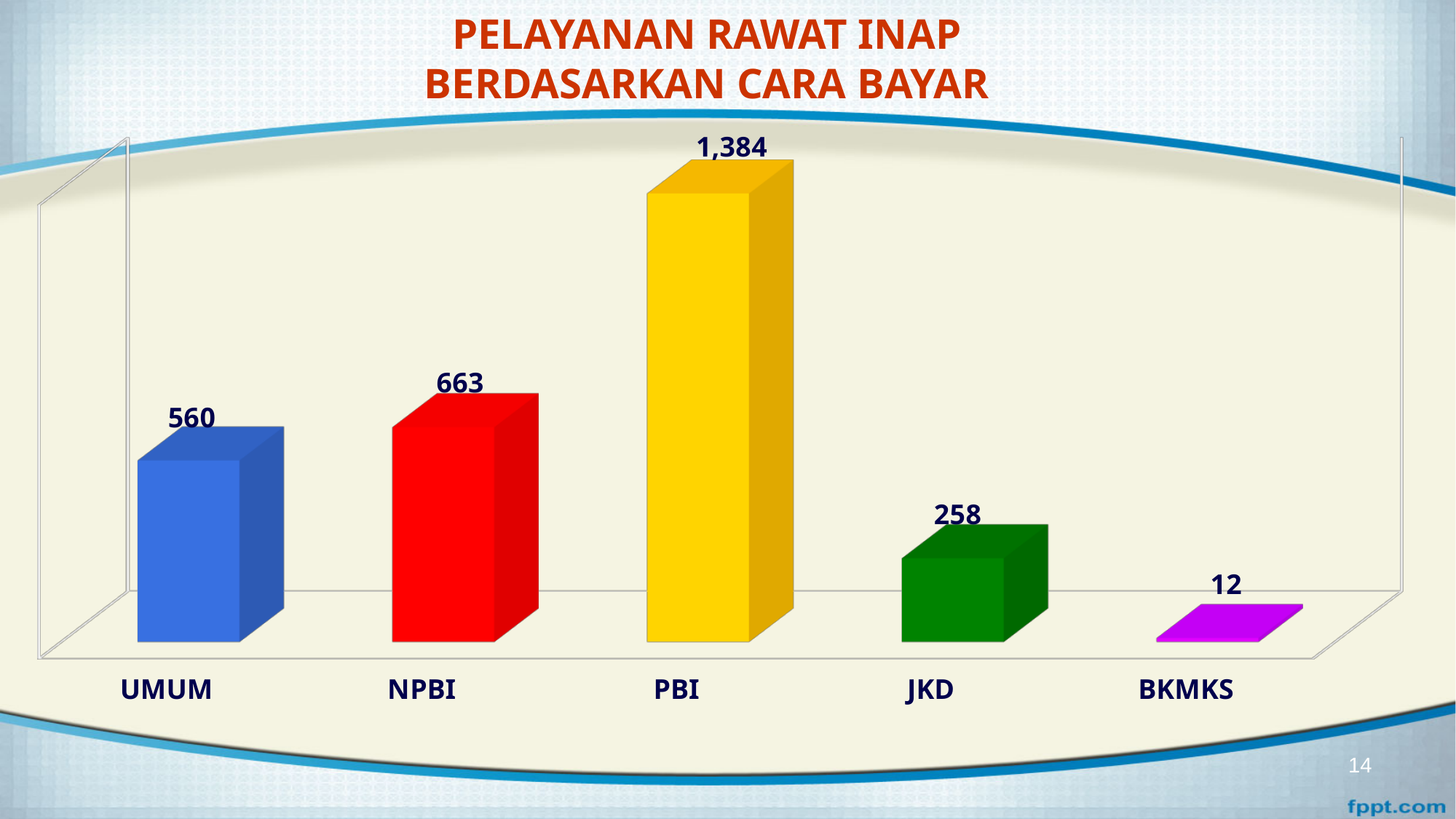
What is the value for BKMKS? 12 How many categories are shown in the chart? 5 What is the value for UMUM? 560 What is the title of the chart? PELAYANAN RAWAT INAP BERDASARKAN CARA BAYAR What is the difference between the values for PBI and JKD? 1,126 What is the difference between the values for NPBI and UMUM? 103 What kind of chart is shown on the slide? Bar chart Which category has the highest value? PBI What is the value for PBI? 1,384 What is the value for JKD? 258 Which is larger, the value for NPBI or the value for UMUM? NPBI Which category has the lowest value? BKMKS